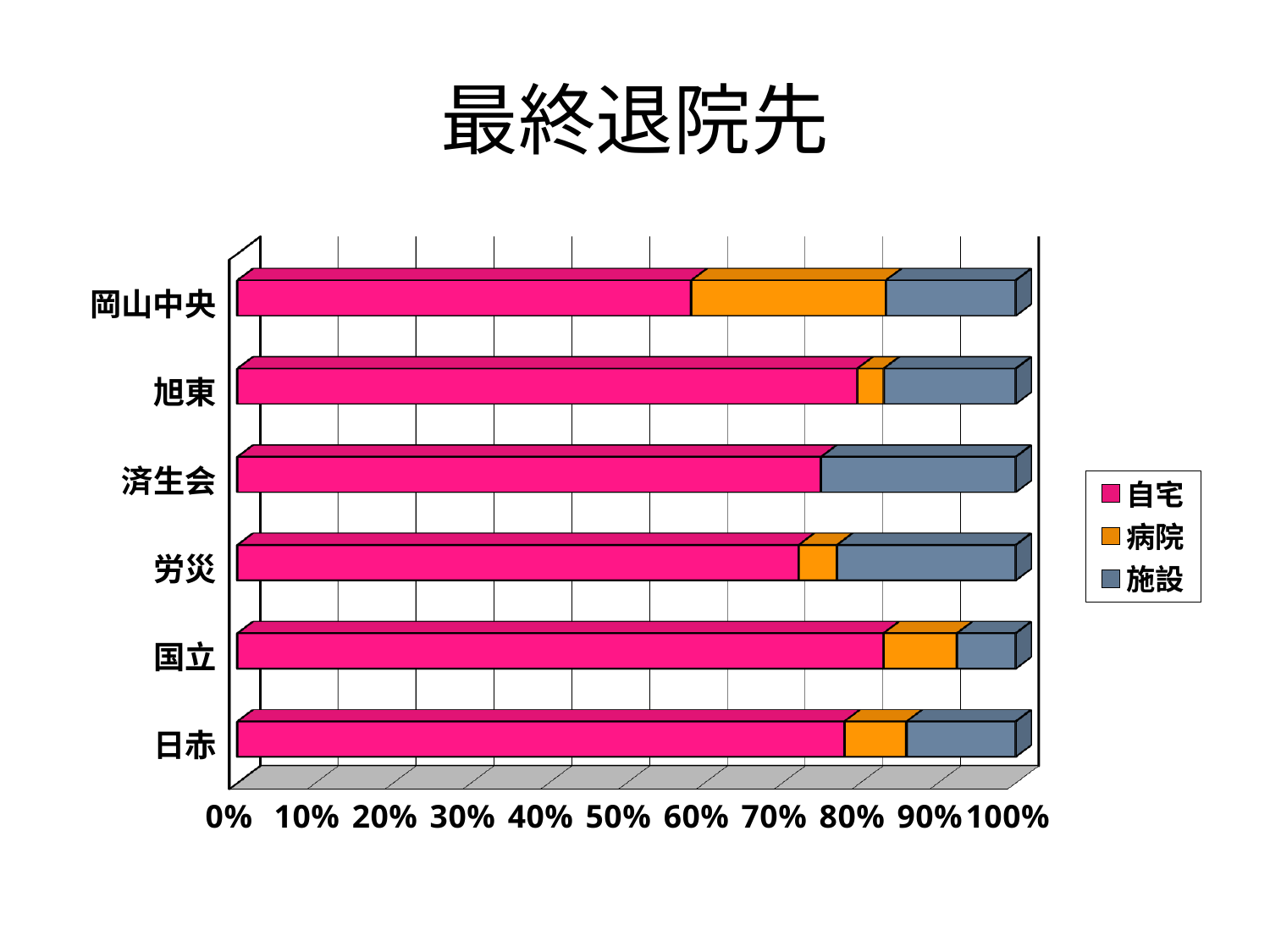
Which hospital has the lowest share for 自宅? 岡山中央 What kind of chart is shown on the slide? stacked bar chart How many series does the legend list? 3 Is the 自宅 value for 岡山中央 greater or less than 70%? less How many hospitals (categories) are shown on the chart? 6 Which series is shown in pink? 自宅 Which hospital has the highest share for 病院? 岡山中央 What is the title of the chart? 最終退院先 Is the 自宅 value for 済生会 greater or less than 70%? greater Is the 自宅 value for 旭東 greater or less than 70%? greater Which has the larger 自宅 share, 岡山中央 or 済生会? 済生会 Which has the larger 病院 share, 岡山中央 or 国立? 岡山中央